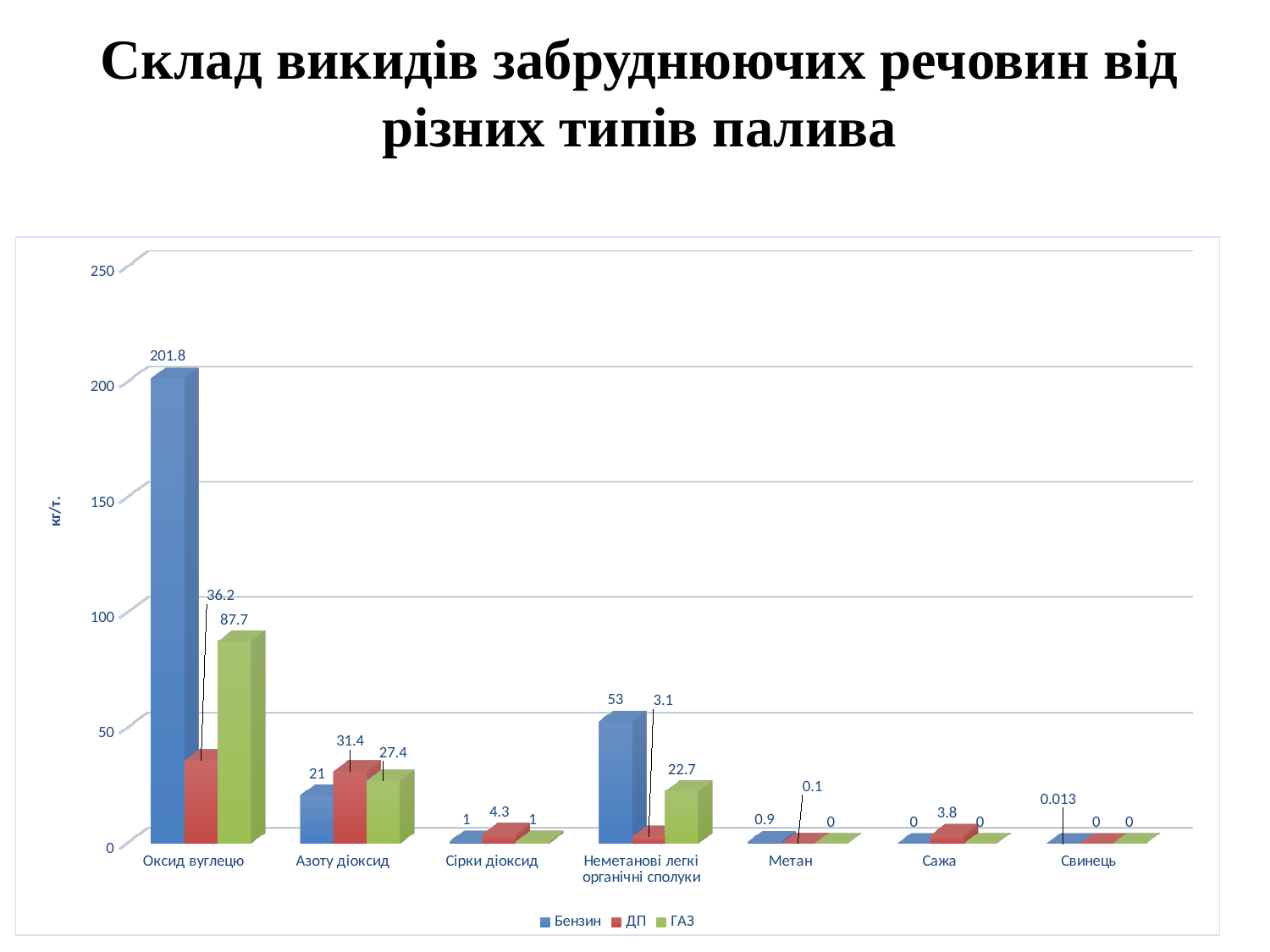
How many series does the legend list? 3 Which is larger in the Неметанові легкі органічні сполуки category, Бензин or ГАЗ? Бензин What is the value for ДП in the Азоту діоксид category? 31.4 What is the label on the vertical axis? кг/т. What is the value for ГАЗ in the Неметанові легкі органічні сполуки category? 22.7 What is the value for Бензин in the Оксид вуглецю category? 201.8 Which category has the highest value for Бензин? Оксид вуглецю What is the value for ГАЗ in the Оксид вуглецю category? 87.7 What kind of chart is shown on the slide? Bar chart How many categories are shown on the x axis? 7 Which series has the lowest value in the Азоту діоксид category? Бензин What is the difference between the Бензин and ГАЗ values for Оксид вуглецю? 114.1